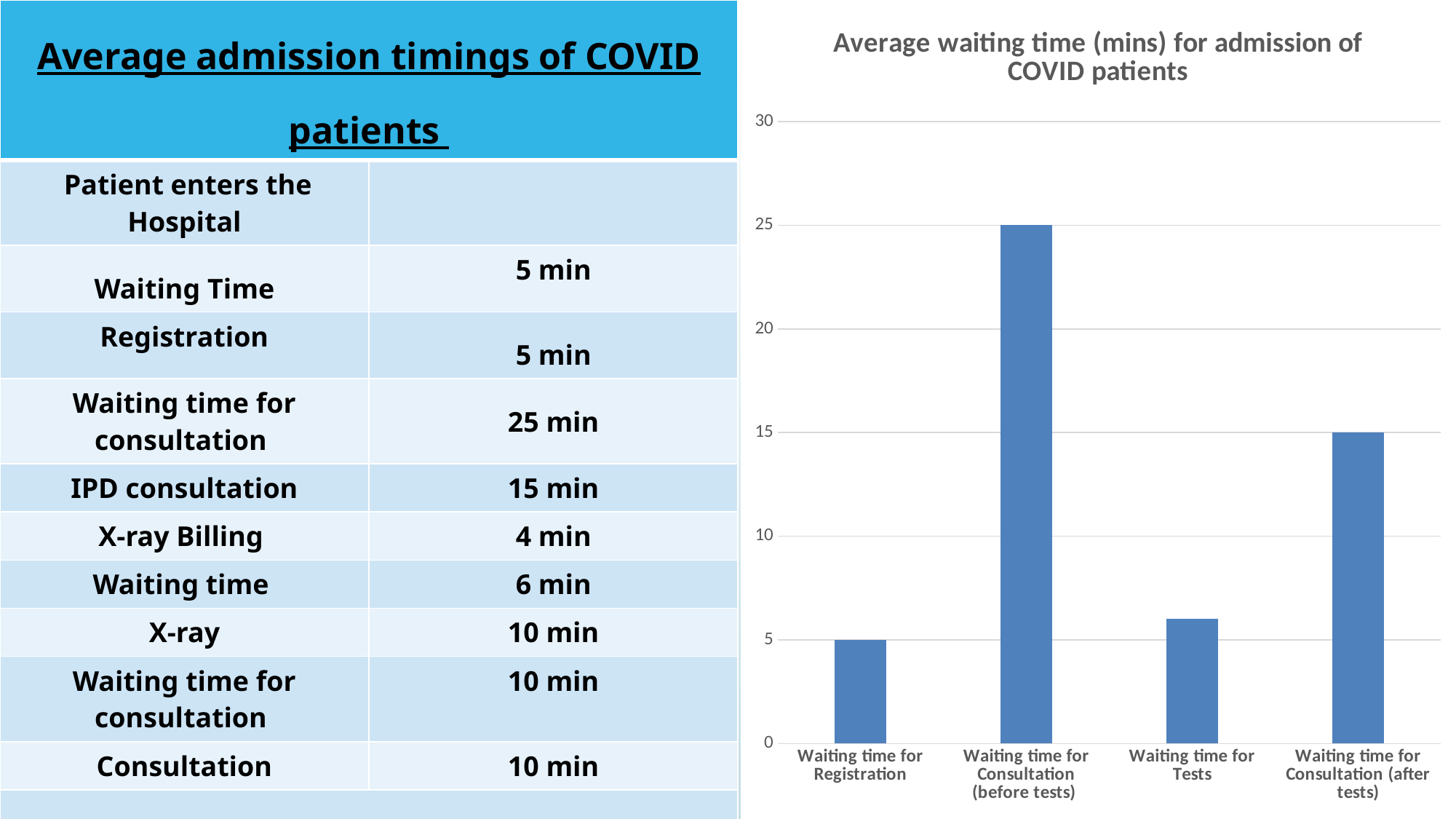
What is the value for Waiting time for Registration? 5 Which category has the lowest value? Waiting time for Registration What is the value for Waiting time for Consultation (after tests)? 15 Which is larger, Waiting time for Consultation (after tests) or Waiting time for Tests? Waiting time for Consultation (after tests) What type of chart is shown on the slide? bar chart Is the value for Waiting time for Tests greater or less than 5? greater Which category has the highest value? Waiting time for Consultation (before tests) What is the title of the chart? Average waiting time (mins) for admission of COVID patients What is the value for Waiting time for Consultation (before tests)? 25 Is the value for Waiting time for Tests greater or less than 10? less How many categories are plotted in the chart? 4 What is the difference between Waiting time for Consultation (before tests) and Waiting time for Consultation (after tests)? 10